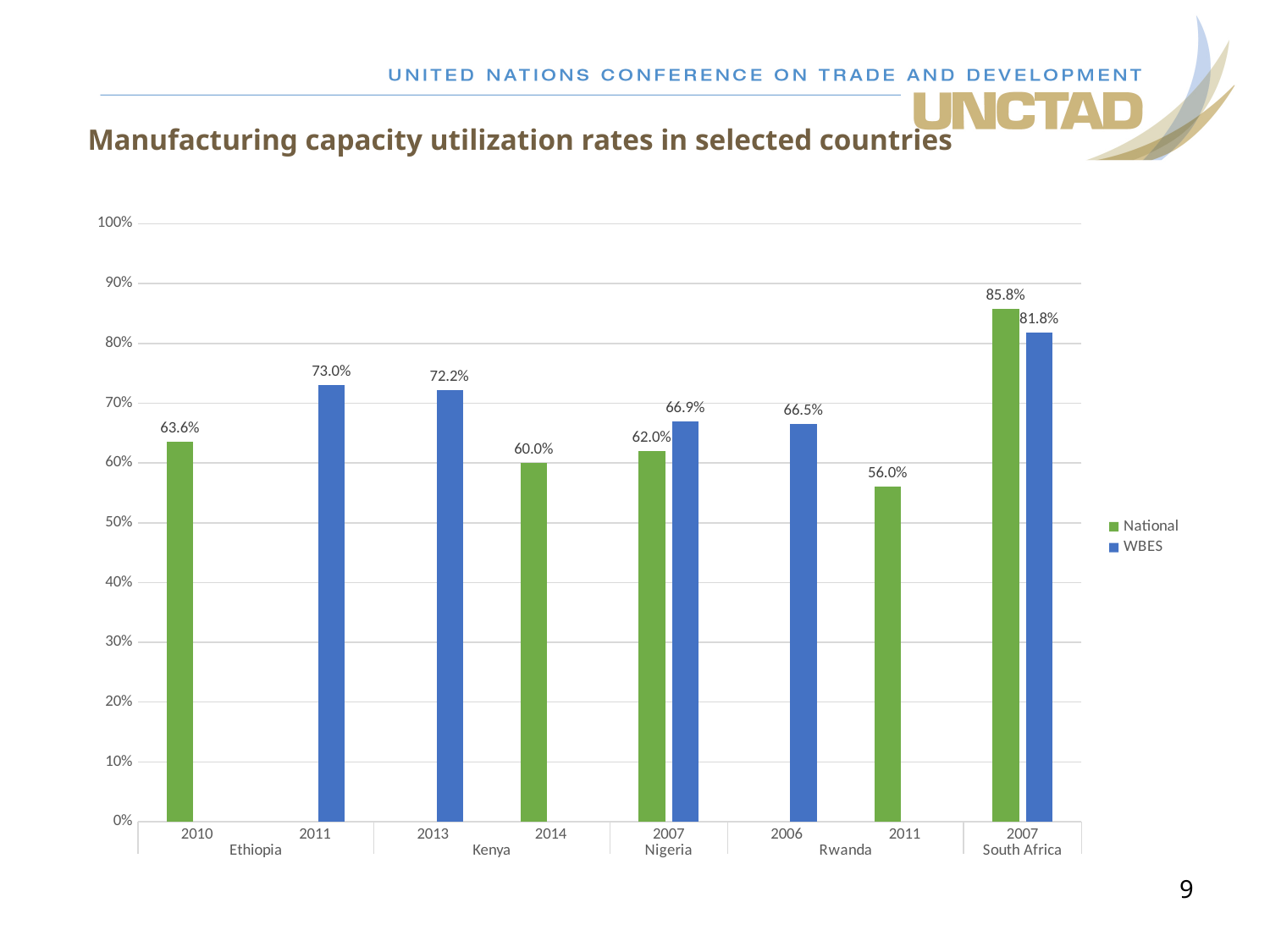
Which country and year has the lowest value shown on the chart? Rwanda 2011 Which country and year has the highest National value? South Africa 2007 For Nigeria in 2007, which is larger, the National value or the WBES value? WBES What is the difference between the National and WBES values for South Africa in 2007? 4.0% How many countries are shown on the x axis? 5 What is the National value for Rwanda in 2011? 56.0% What is the WBES value for Kenya in 2013? 72.2% What is the difference between the WBES value for Ethiopia in 2011 and the National value for Ethiopia in 2010? 9.4% What is the National manufacturing capacity utilization rate for Ethiopia in 2010? 63.6% What kind of chart is shown on the slide? Bar chart What is the WBES value for South Africa in 2007? 81.8% How many series does the legend list? 2